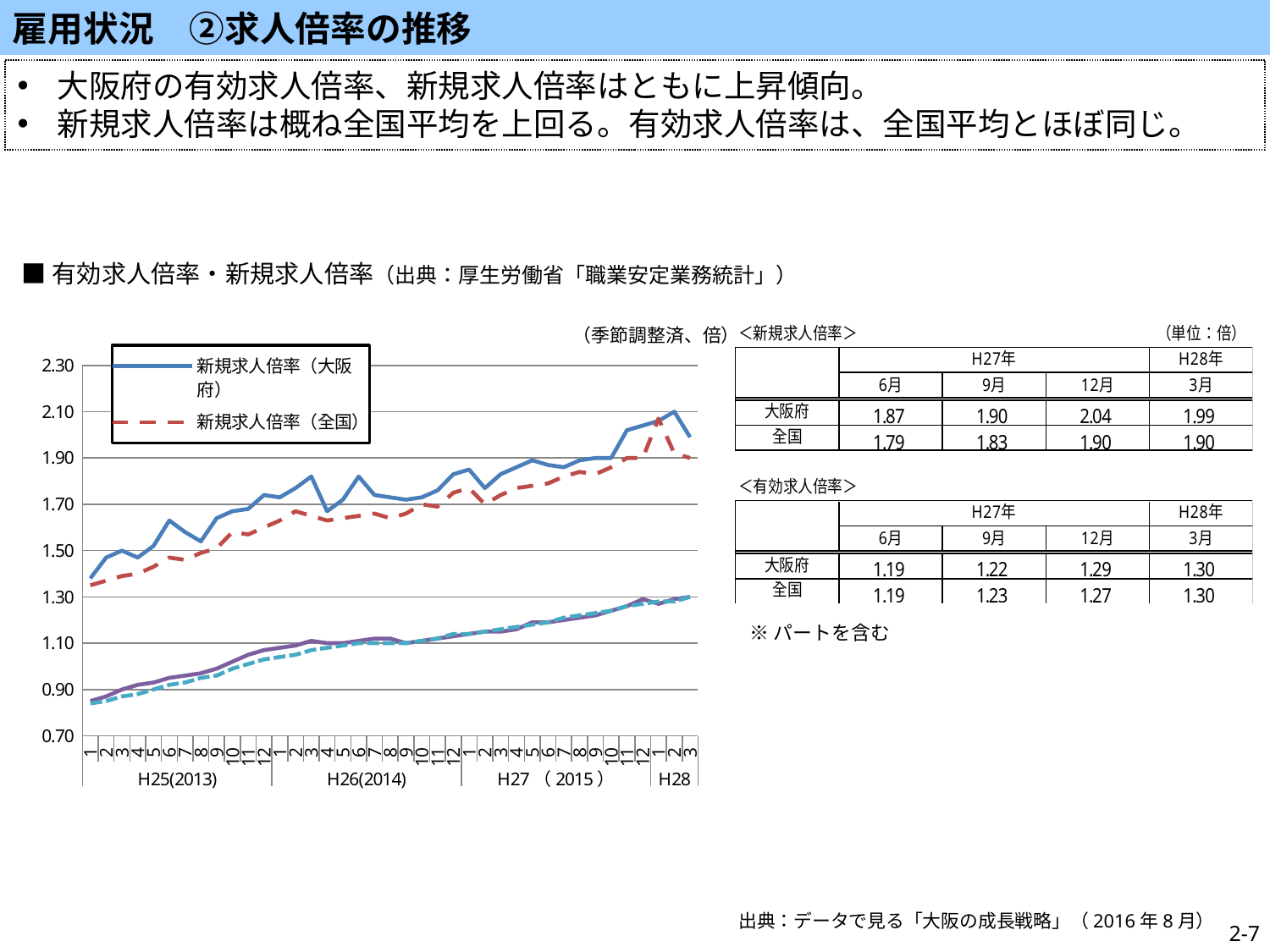
What are the two series named in the chart's legend? 新規求人倍率（大阪府） and 新規求人倍率（全国） How many year groups are labelled along the chart's horizontal axis? 4 Is the value of 新規求人倍率（大阪府） in month 2 of H28 greater or less than 1.90? greater In month 1 of H26(2014), which is higher: 新規求人倍率（大阪府） or 新規求人倍率（全国）? 新規求人倍率（大阪府） What is the highest value shown on the chart's vertical axis? 2.30 Is the value of 新規求人倍率（全国） in month 1 of H25(2013) greater or less than 1.50? less What kind of chart is shown on the slide? line chart Is the value of 新規求人倍率（大阪府） in month 1 of H25(2013) greater or less than 1.50? less How many series does the chart's legend list? 2 Does the 新規求人倍率（全国） line generally rise or fall across the period shown? rise Does the 新規求人倍率（大阪府） line generally rise or fall from H25(2013) to H28? rise